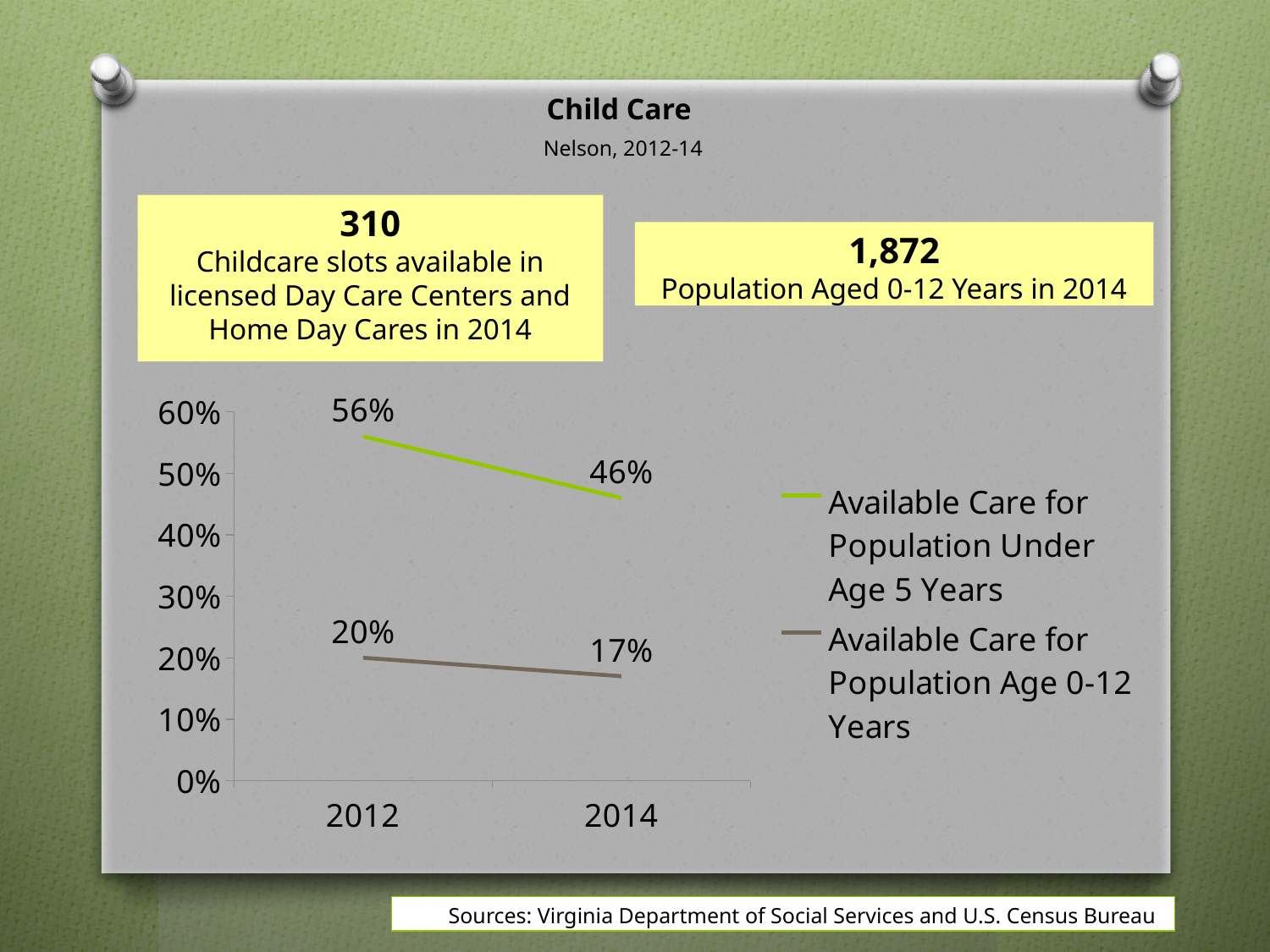
Does the value for Available Care for Population Under Age 5 Years rise or fall from 2012 to 2014? fall Which series has the higher value in 2012? Available Care for Population Under Age 5 Years Does the value for Available Care for Population Age 0-12 Years rise or fall from 2012 to 2014? fall What is the value for Available Care for Population Age 0-12 Years in 2012? 20% By how many percentage points did Available Care for Population Under Age 5 Years change from 2012 to 2014? 10 percentage points What is the value for Available Care for Population Age 0-12 Years in 2014? 17% What is the difference between the two series' values in 2014? 29 percentage points How many series does the legend list? 2 How many years are shown on the x axis? 2 What kind of chart is shown on the slide? line chart What is the value for Available Care for Population Under Age 5 Years in 2014? 46% What is the value for Available Care for Population Under Age 5 Years in 2012? 56%